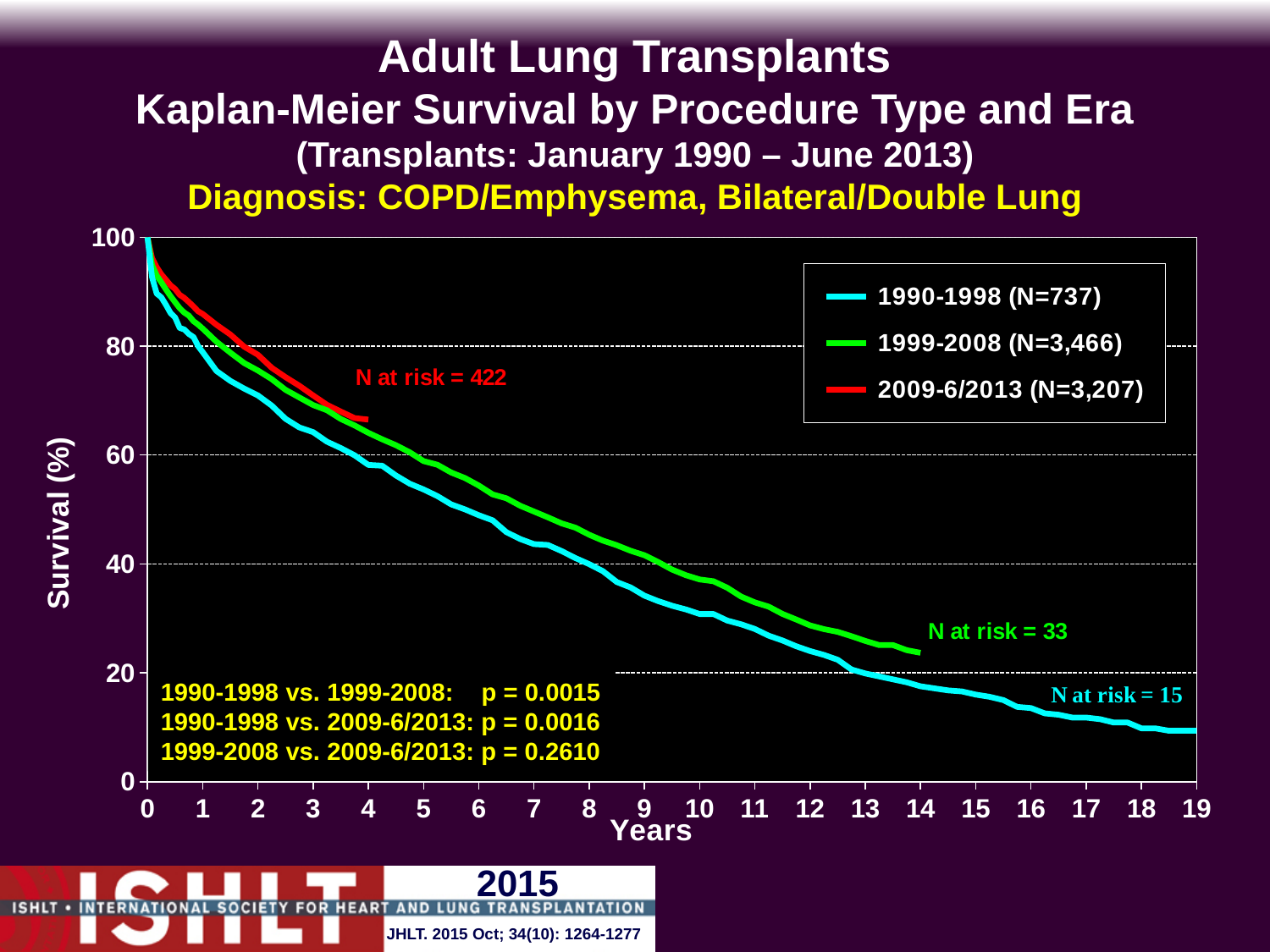
What is the N at risk printed for the 1990-1998 series? 15 What is the p-value shown for 1990-1998 vs. 2009-6/2013? 0.0016 How many series does the legend list? 3 Is the survival value for the 2009-6/2013 series at 3 years greater or less than 60? greater What is the N at risk printed for the 2009-6/2013 series? 422 Do the survival curves rise or fall as years increase? fall What kind of chart is shown on the slide? line chart Which series has the lowest survival at 2 years? 1990-1998 What is the N given in the legend for the 1999-2008 series? 3,466 At 10 years, which series has higher survival: 1999-2008 or 1990-1998? 1999-2008 Is the survival value for the 1990-1998 series at 10 years greater or less than 40? less What is the N at risk printed for the 1999-2008 series? 33